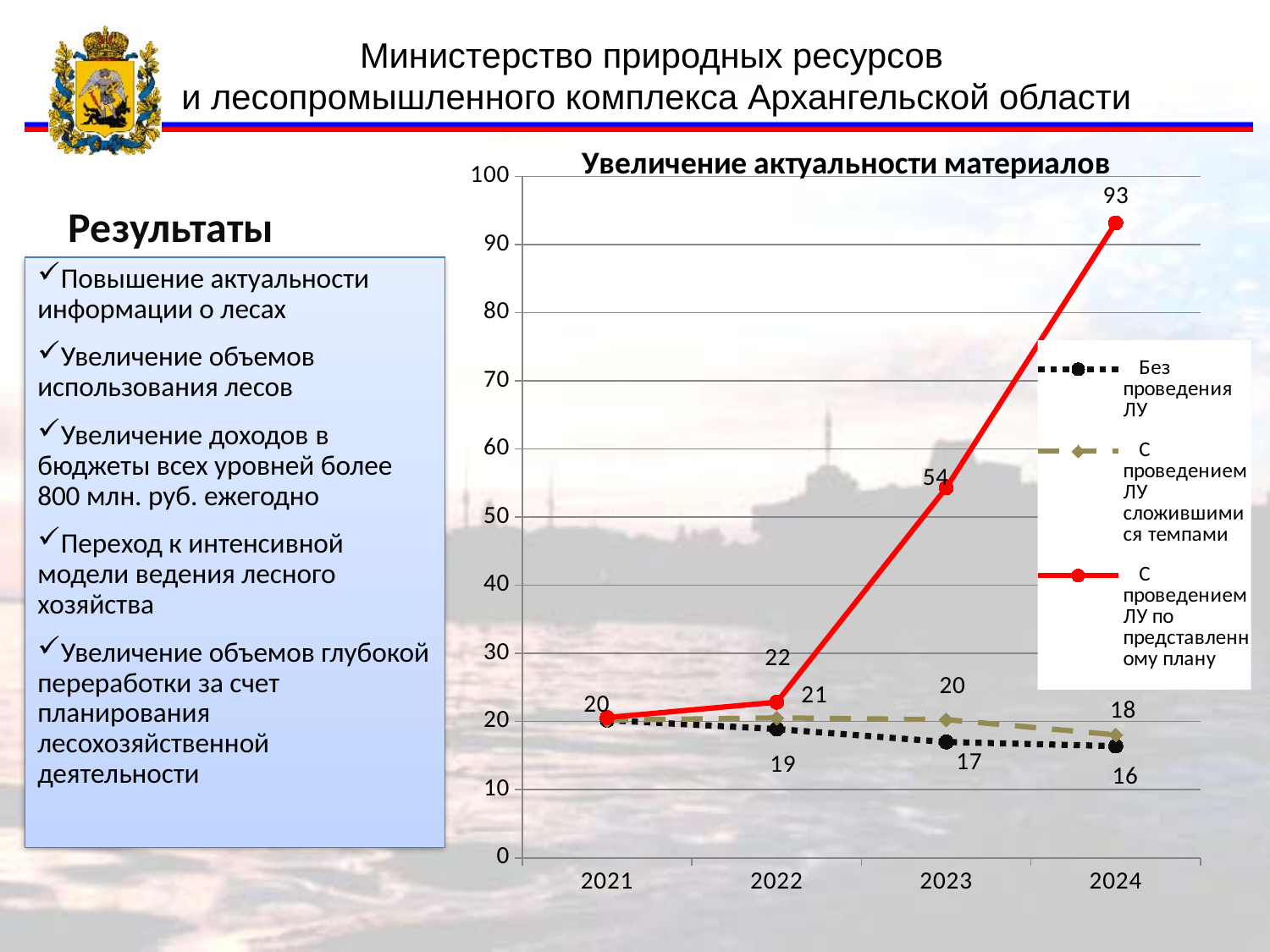
In which year does the series 'С проведением ЛУ по представленному плану' reach its highest value? 2024 What is the value for 2024 for the series 'С проведением ЛУ по представленному плану'? 93 What is the title of the chart? Увеличение актуальности материалов What is the value for 2023 for the series 'С проведением ЛУ по представленному плану'? 54 How many series does the chart legend list? 3 What is the value for 2022 for the series 'С проведением ЛУ сложившимися темпами'? 21 What is the difference between the 2024 values of 'С проведением ЛУ по представленному плану' (93) and 'Без проведения ЛУ' (16)? 77 What type of chart is shown on the slide? line chart Which series has the larger value in 2023: 'С проведением ЛУ по представленному плану' or 'Без проведения ЛУ'? С проведением ЛУ по представленному плану Does the series 'Без проведения ЛУ' rise or fall from 2021 to 2024? fall How many years are shown on the x axis of the chart? 4 What is the value for 2024 for the series 'Без проведения ЛУ'? 16